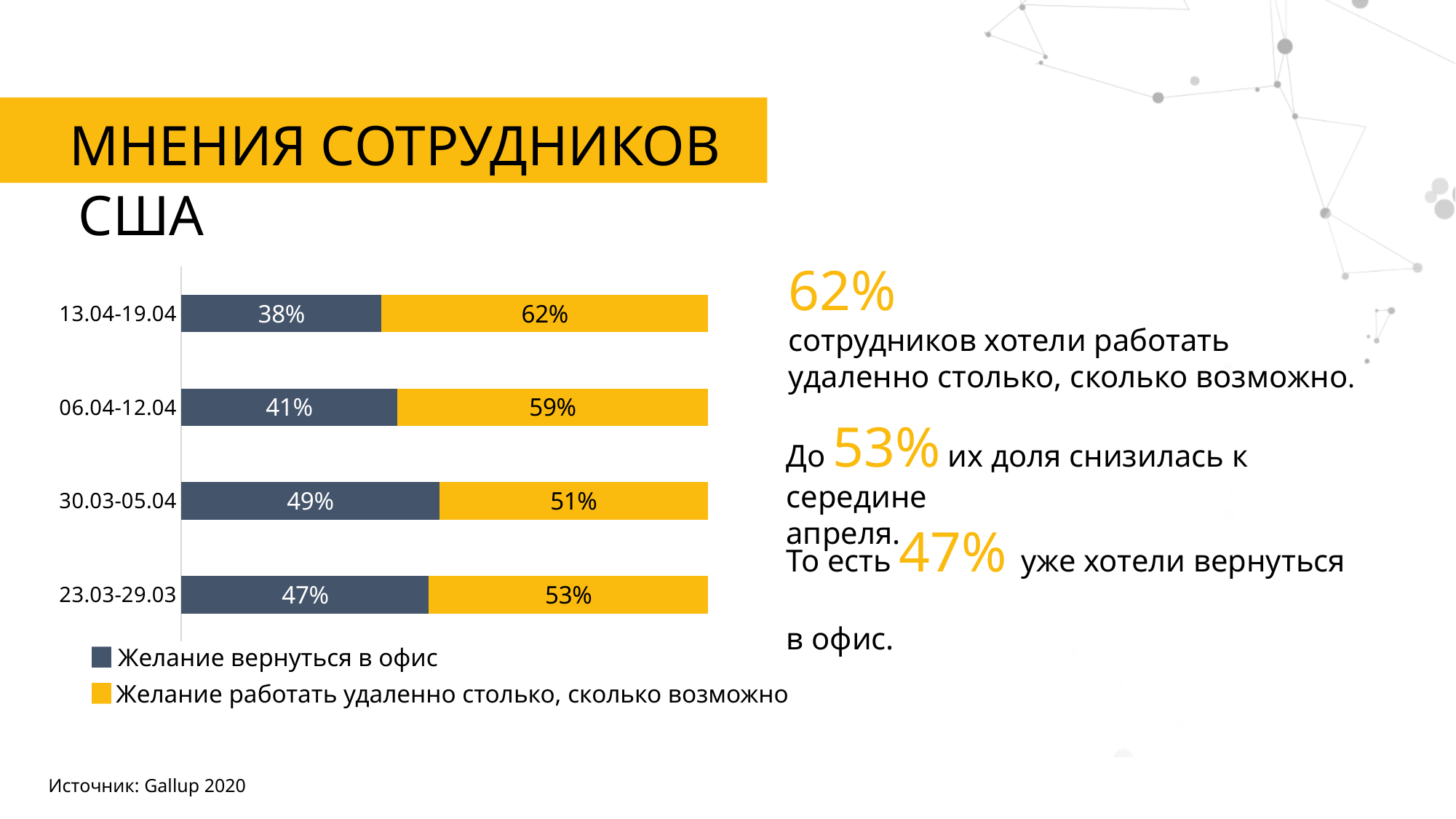
How many date periods (categories) does the chart show? 4 What is the value of "Желание работать удаленно столько, сколько возможно" for the period 06.04-12.04? 59% In which period is the value of "Желание вернуться в офис" lowest? 13.04-19.04 What is the value of "Желание вернуться в офис" for the period 13.04-19.04? 38% What is the total of the stacked bar for the period 06.04-12.04? 100% How many series does the chart legend list? 2 What kind of chart is shown on the slide? stacked bar chart What is the value of "Желание вернуться в офис" for the period 30.03-05.04? 49% What is the value of "Желание работать удаленно столько, сколько возможно" for the period 23.03-29.03? 53% Which is larger for the period 30.03-05.04: "Желание вернуться в офис" or "Желание работать удаленно столько, сколько возможно"? Желание работать удаленно столько, сколько возможно What is the difference between the "Желание работать удаленно столько, сколько возможно" values for 13.04-19.04 and 23.03-29.03? 9% In which period is the value of "Желание работать удаленно столько, сколько возможно" highest? 13.04-19.04